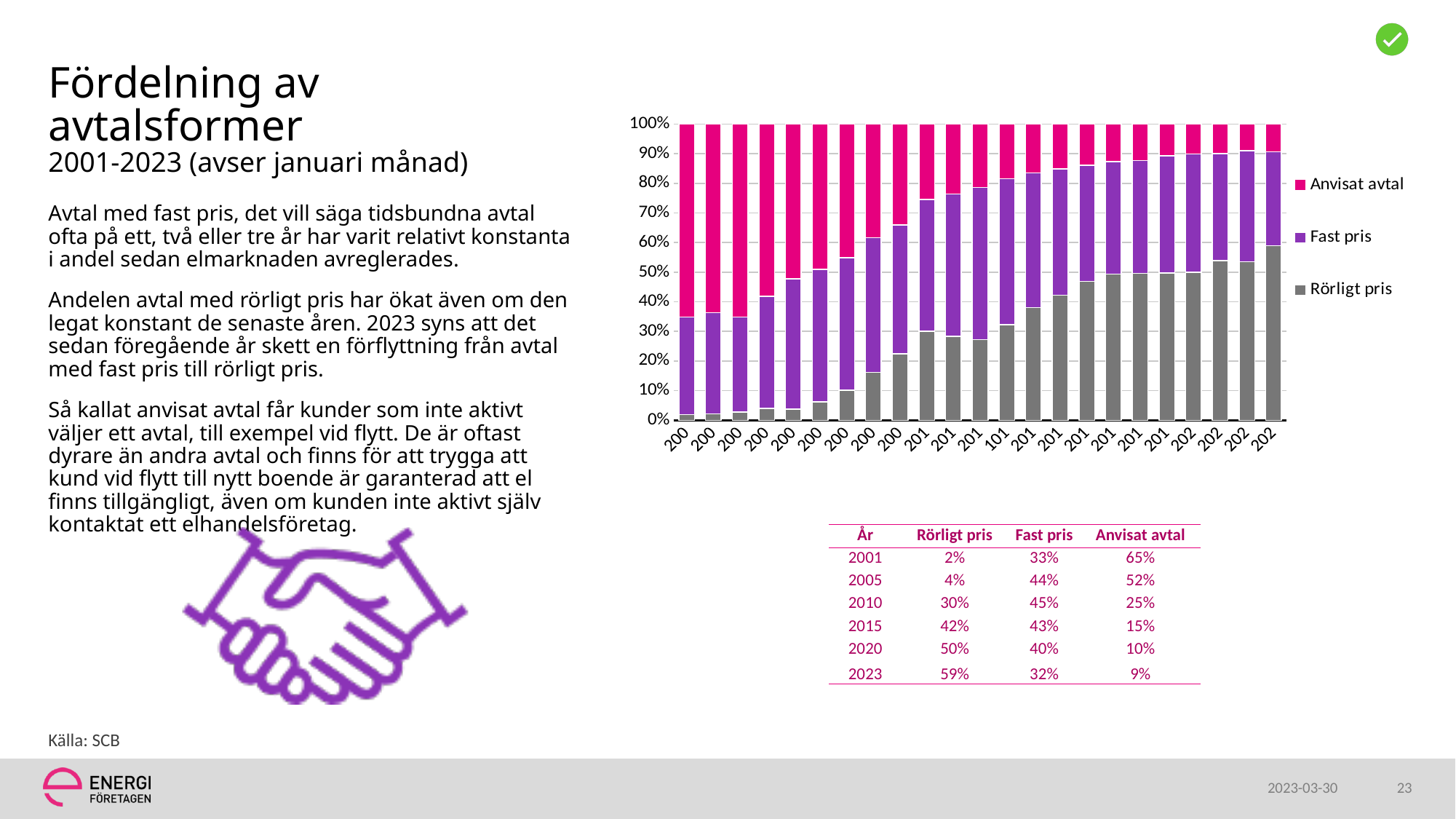
In the leftmost bar (2001), is the Rörligt pris share greater or less than 10%? less How many series does the chart legend list? 3 According to the table on the slide, what is the Rörligt pris share for 2023? 59% Does the share of Rörligt pris rise or fall from the leftmost bar to the rightmost bar? Rise Which colour represents Anvisat avtal in the chart? Pink (magenta) In the leftmost bar (2001), which segment is larger: Anvisat avtal or Rörligt pris? Anvisat avtal In the rightmost bar (2023), which segment is larger: Rörligt pris or Fast pris? Rörligt pris Does the share of Anvisat avtal rise or fall across the years from left to right? Fall In the rightmost bar (2023), is the Rörligt pris share greater or less than 50%? greater What are the three series named in the chart legend? Anvisat avtal, Fast pris, Rörligt pris How many bars (years) are plotted in the chart? 23 What kind of chart is shown on the slide? Stacked bar chart